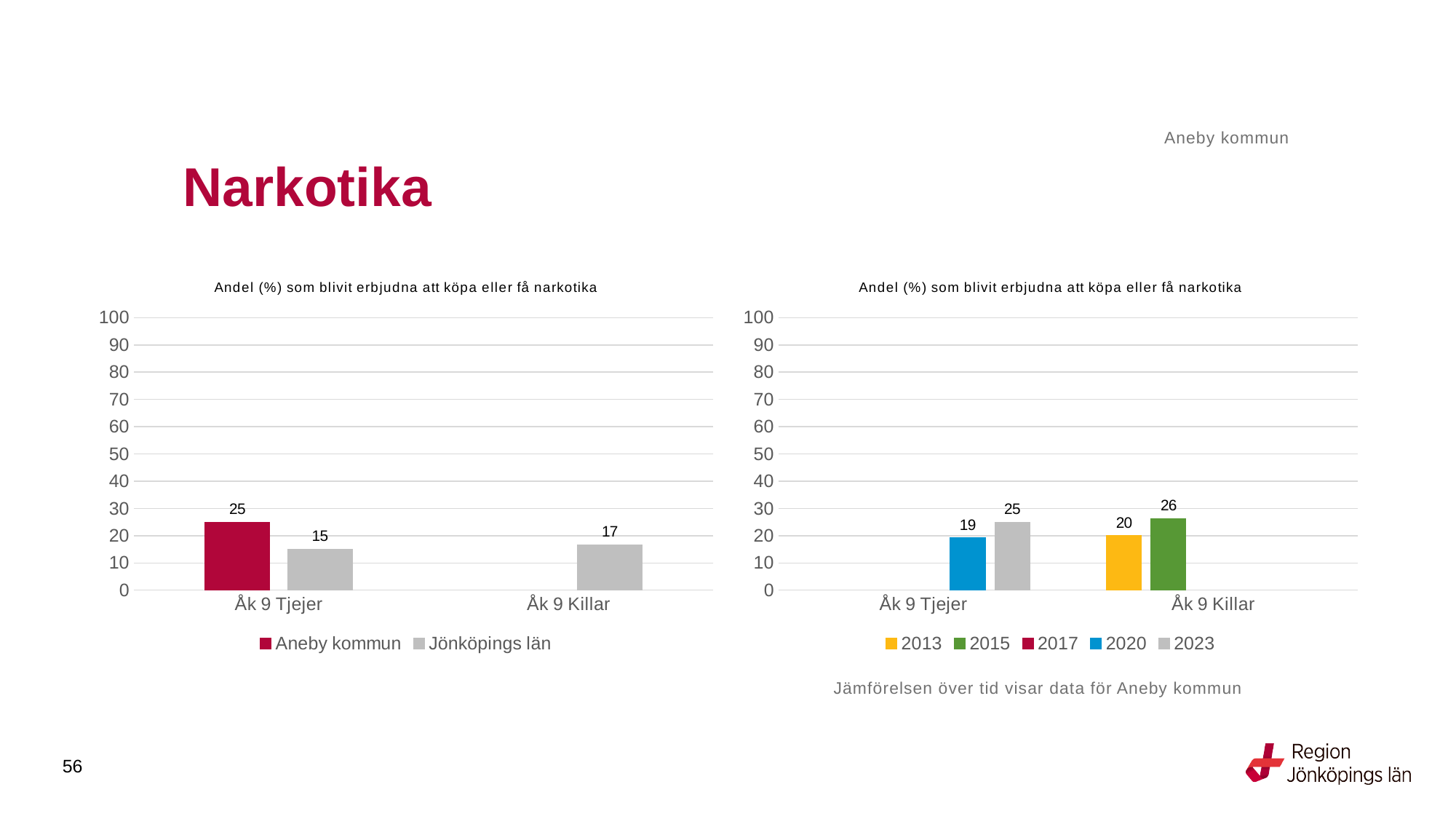
In the right chart, what is the value for 2020 for Åk 9 Tjejer? 19 In the right chart, what is the difference between 2023 and 2020 for Åk 9 Tjejer? 6 In the left chart, what is the value for Aneby kommun for Åk 9 Tjejer? 25 In the left chart, what is the value for Jönköpings län for Åk 9 Killar? 17 In the left chart, how many series does the legend list? 2 In the right chart, what is the value for 2015 for Åk 9 Killar? 26 In the left chart, which is larger for Åk 9 Tjejer: Aneby kommun or Jönköpings län? Aneby kommun In the left chart, what is the difference between Aneby kommun and Jönköpings län for Åk 9 Tjejer? 10 In the right chart, which bar is the highest? 2015, Åk 9 Killar What kind of chart is the left chart? bar chart In the right chart, is the value for 2013 for Åk 9 Killar greater or less than 30? less In the right chart, how many series does the legend list? 5